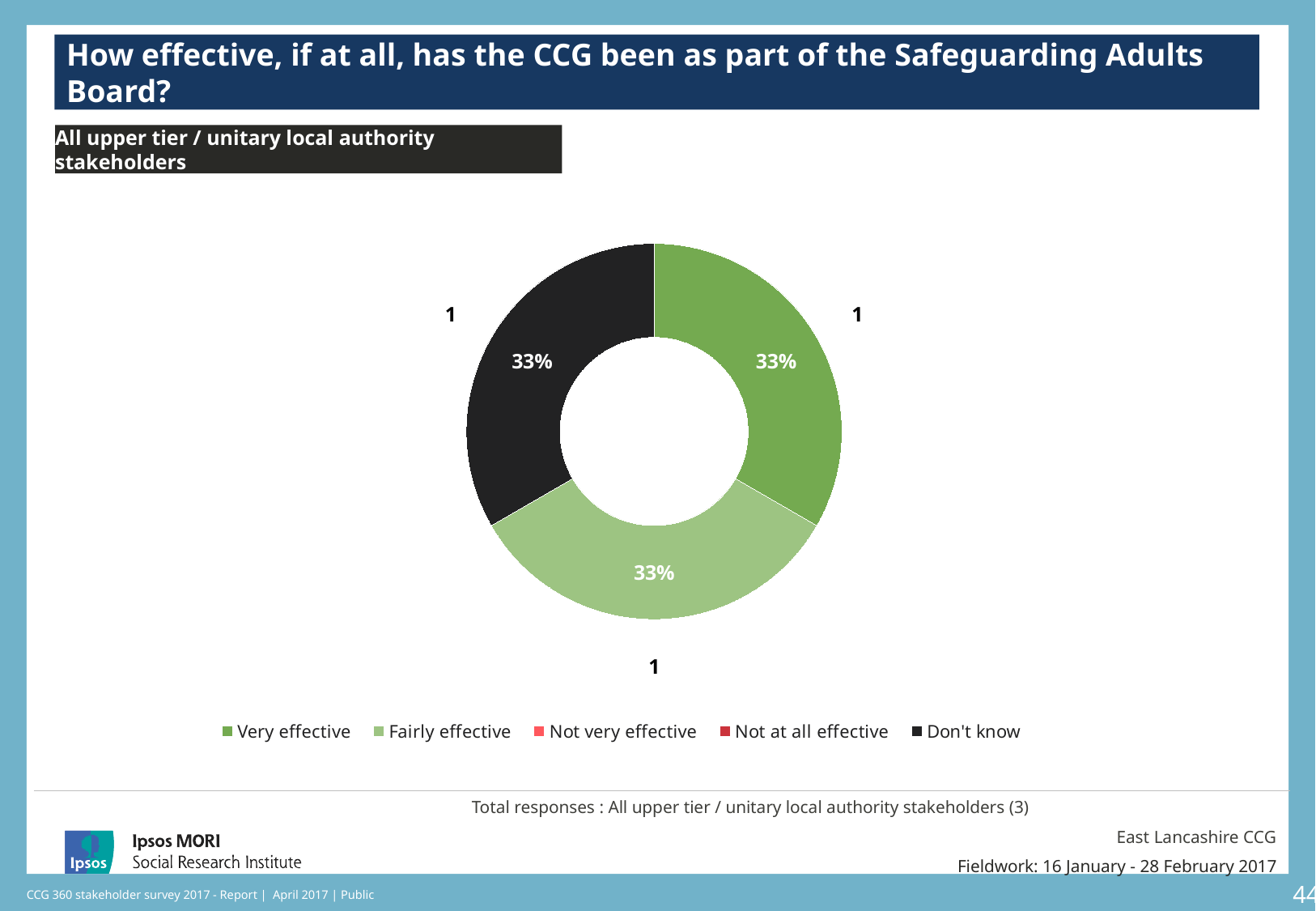
How many respondents answered 'Don't know'? 1 What percentage of respondents said the CCG has been very effective as part of the Safeguarding Adults Board? 33% How many slices are visible in the chart? 3 What is the total number of responses shown for all upper tier / unitary local authority stakeholders? 3 How many respondents answered 'Very effective'? 1 What kind of chart is shown on the slide? Pie chart (donut) How many categories does the legend list? 5 Is the share for 'Fairly effective' greater or less than 50%? less What percentage of respondents said the CCG has been fairly effective? 33% Which stakeholder group does the chart cover? All upper tier / unitary local authority stakeholders Which legend category is shown in black in the chart? Don't know What percentage of respondents answered 'Don't know'? 33%